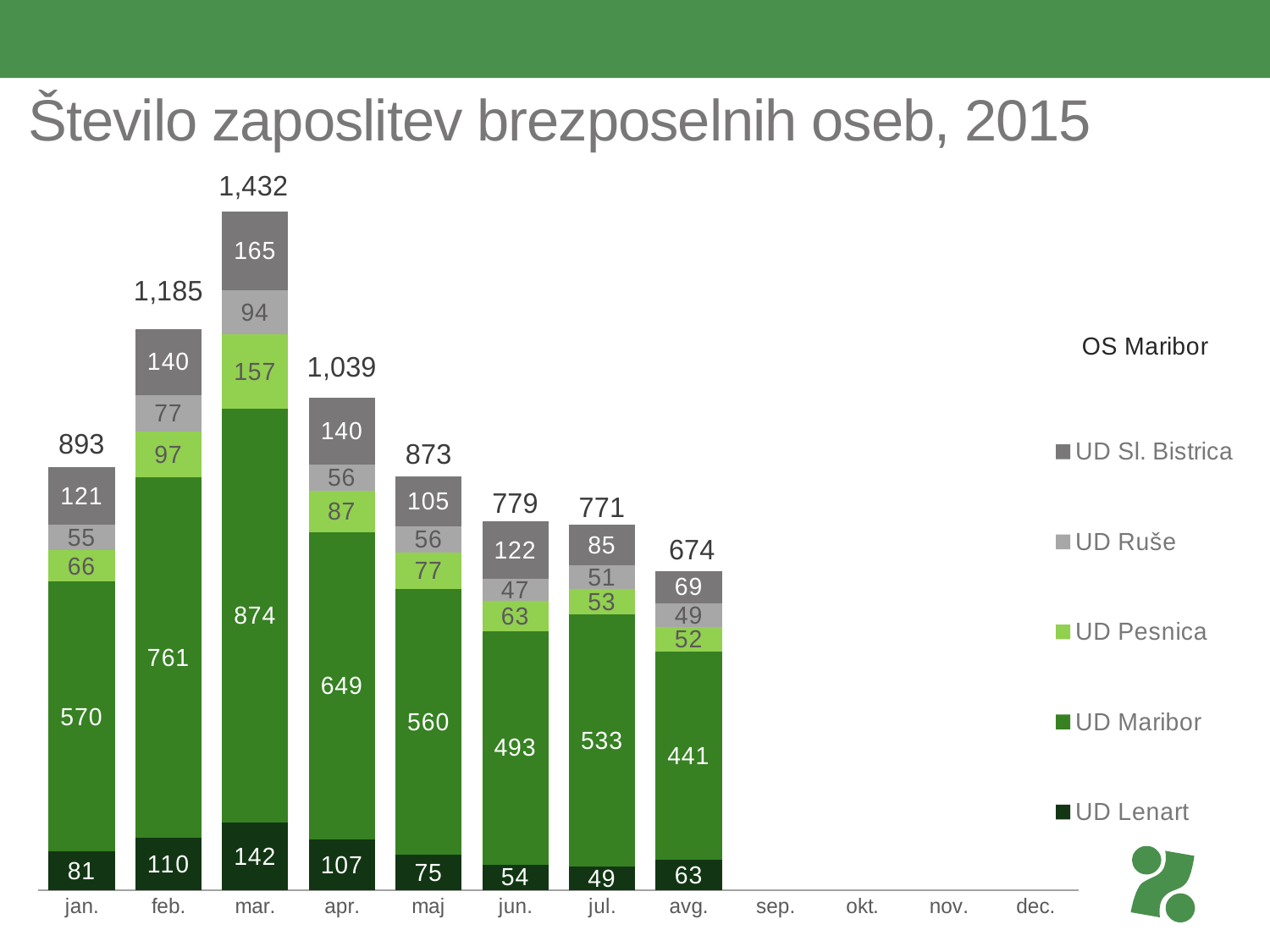
What is the difference between the total for mar. and the total for jan.? 539 Which is larger, the UD Lenart value for jan. or for feb.? feb. Which month has the highest total? mar. What is the total of the stacked bar for avg.? 674 How many months have bars plotted? 8 What is the total shown above the feb. bar? 1,185 What is the value for UD Maribor in mar.? 874 Among the months with data, which month has the lowest total? avg. What is the title of the chart? Število zaposlitev brezposelnih oseb, 2015 Do the monthly totals rise or fall from mar. to avg.? Fall What is the value for UD Sl. Bistrica in jun.? 122 What kind of chart is shown? Stacked bar chart